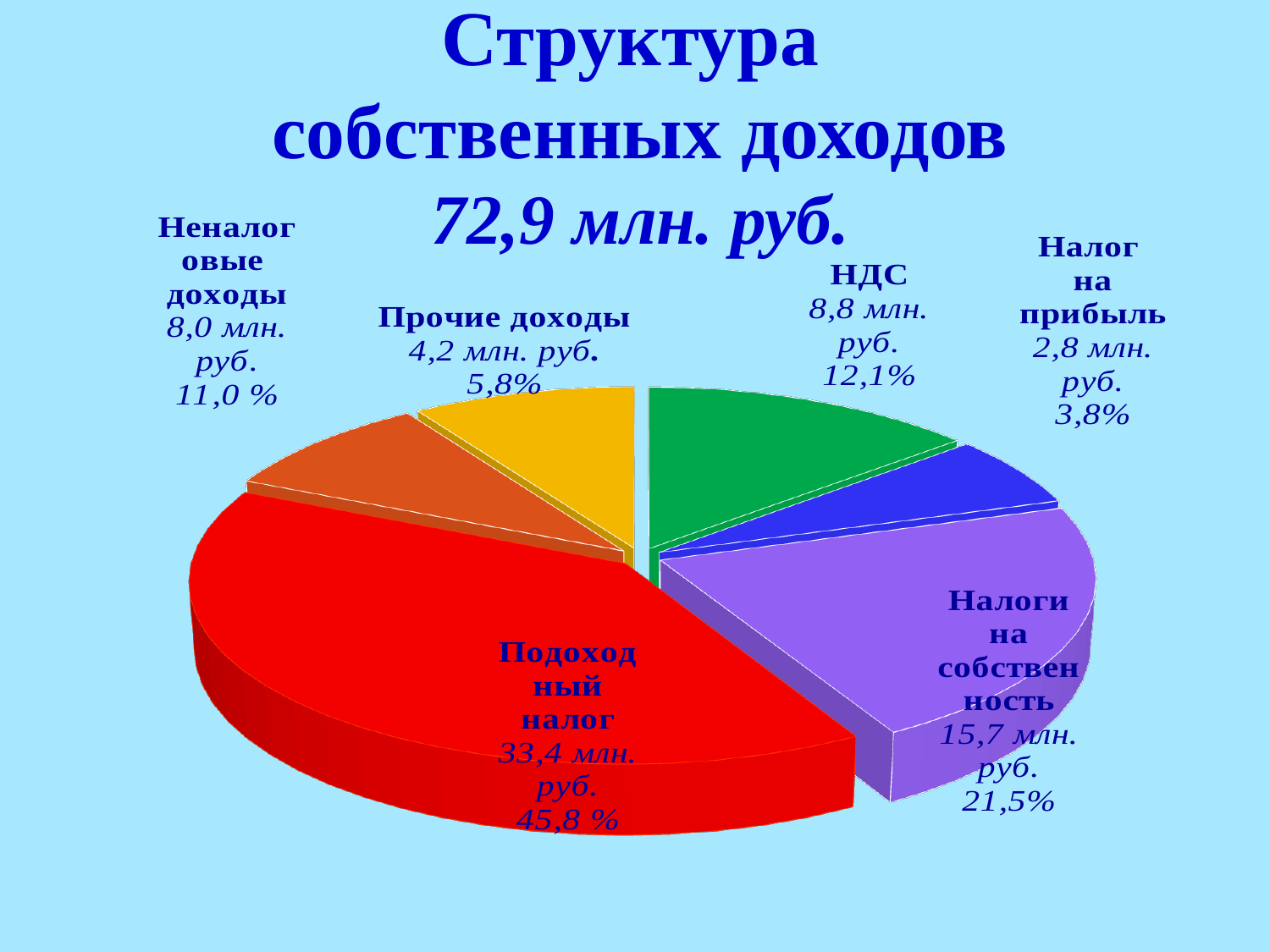
What total amount is stated in the chart title? 72,9 млн. руб. Which category has the smallest slice? Налог на прибыль What is the difference between the values for Подоходный налог and Налоги на собственность? 17,7 млн. руб. What kind of chart is shown on the slide? pie chart What is the value for Подоходный налог? 33,4 млн. руб. Which is larger, Неналоговые доходы or НДС? НДС What share of the pie does Налог на прибыль represent? 3,8% What is the value for Налоги на собственность? 15,7 млн. руб. What colour is the slice for Прочие доходы? yellow What share of the pie does НДС represent? 12,1% How many slices does the pie chart have? 6 Which category has the largest slice? Подоходный налог